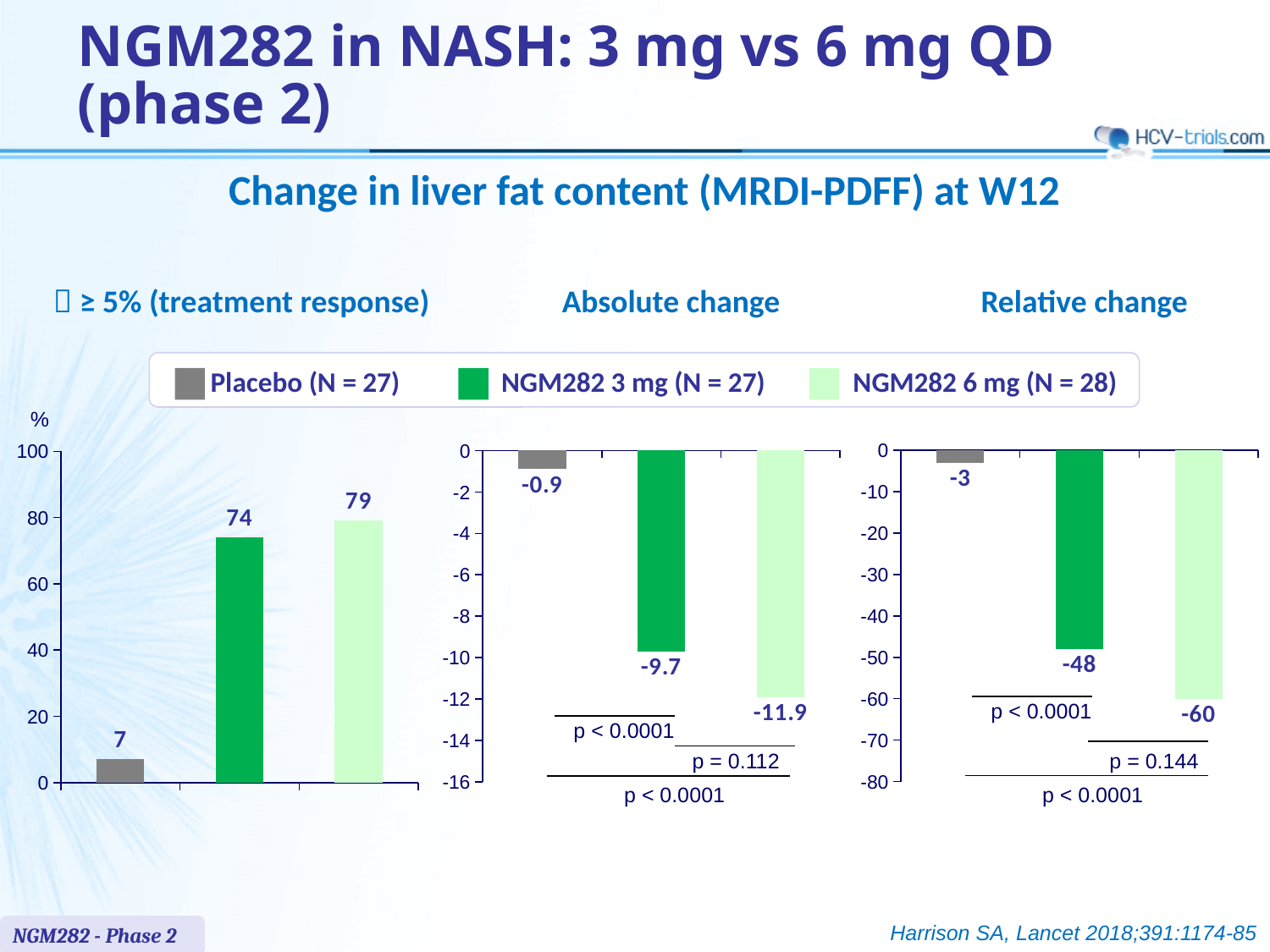
In the left chart (≥ 5% treatment response), what is the difference between the NGM282 6 mg and Placebo values? 72 In the Absolute change chart, which group has the lowest (most negative) value? NGM282 6 mg In the left chart (≥ 5% treatment response), which group has the highest value? NGM282 6 mg In the left chart (≥ 5% treatment response), what is the value for NGM282 3 mg? 74 In the Relative change chart, is the value for Placebo or NGM282 3 mg closer to zero? Placebo What kind of chart is the Absolute change chart? Bar chart In the Absolute change chart, what is the value for Placebo? -0.9 How many series does the legend list? 3 In the Absolute change chart, what is the value for NGM282 6 mg? -11.9 In the Relative change chart, what is the difference between the NGM282 6 mg and NGM282 3 mg values? 12 In the Relative change chart, what is the value for NGM282 3 mg? -48 In the left chart (≥ 5% treatment response), what is the value for Placebo? 7